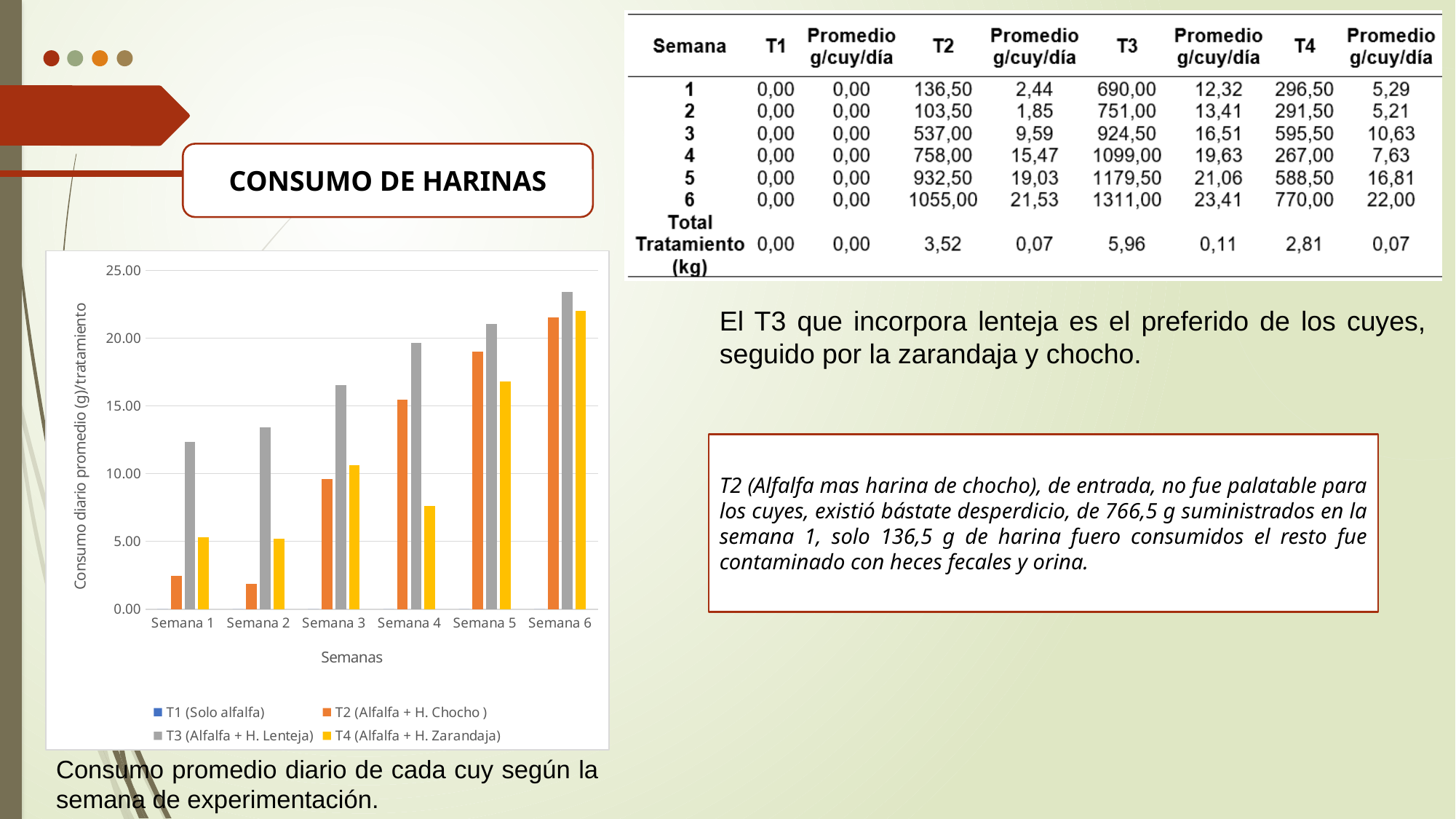
Does the value for T3 (Alfalfa + H. Lenteja) rise or fall from Semana 1 to Semana 6? Rise In Semana 6, which series has the highest bar? T3 (Alfalfa + H. Lenteja) Is the value for T4 (Alfalfa + H. Zarandaja) in Semana 4 greater or less than 10.00? less Is the value for T2 (Alfalfa + H. Chocho) in Semana 2 greater or less than 5.00? less How many series does the chart legend list? 4 In Semana 5, which is larger: T2 (Alfalfa + H. Chocho) or T4 (Alfalfa + H. Zarandaja)? T2 (Alfalfa + H. Chocho) Is the value for T3 (Alfalfa + H. Lenteja) in Semana 1 greater or less than 10.00? greater How many weeks (categories) are shown on the x axis of the chart? 6 In which week is the bar for T2 (Alfalfa + H. Chocho) the lowest? Semana 2 What kind of chart is shown on the slide? Bar chart What is the title of the x axis of the chart? Semanas In Semana 3, which is larger: T3 (Alfalfa + H. Lenteja) or T4 (Alfalfa + H. Zarandaja)? T3 (Alfalfa + H. Lenteja)